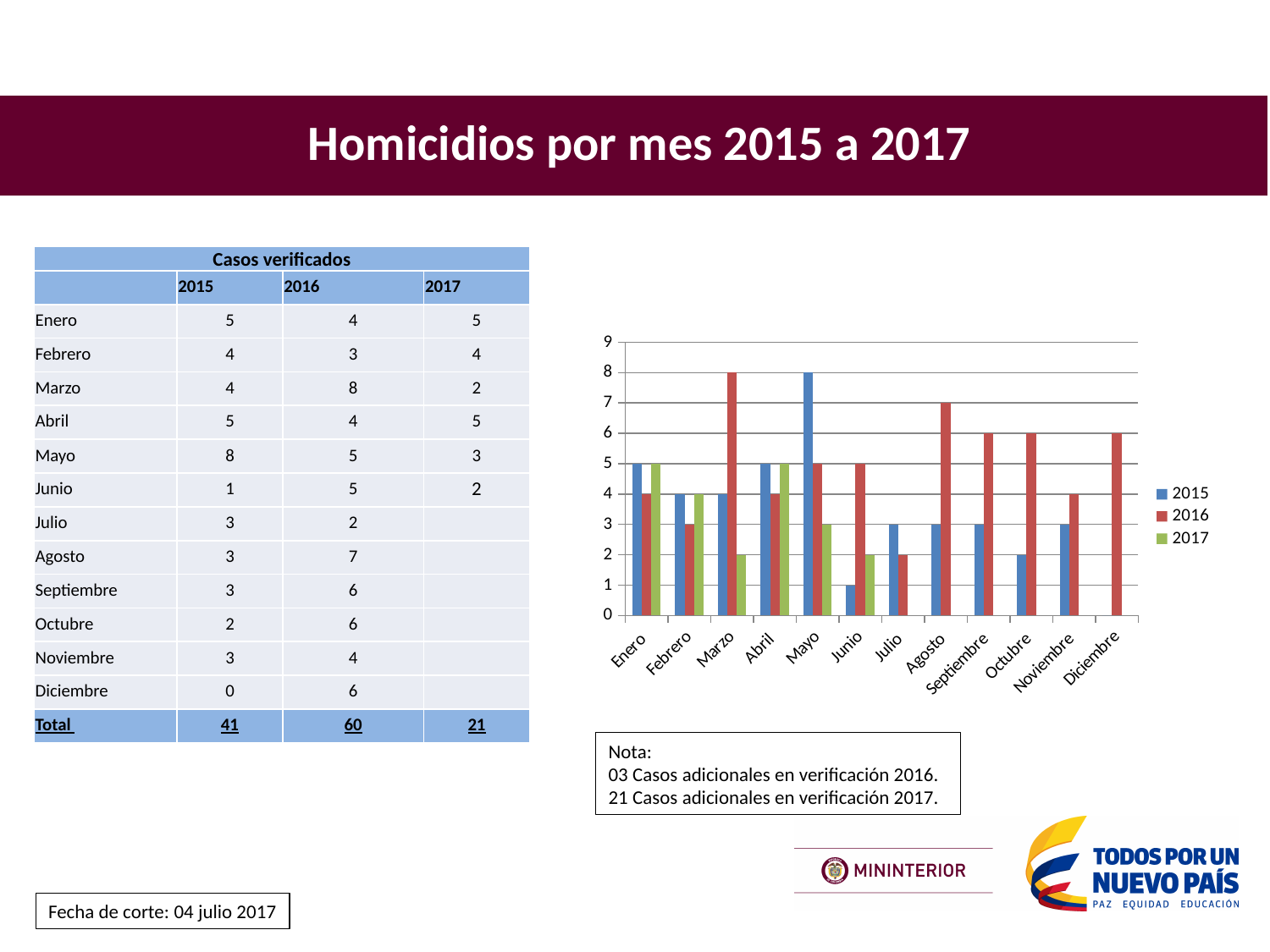
Is the value for 2016 in Septiembre greater or less than 5? greater How many series does the chart legend list? 3 What is the difference between the 2016 and 2015 values in Agosto? 4 Which month has the lowest value for the 2015 series? Diciembre What is the value for 2015 in Mayo? 8 Which series is shown in green in the chart legend? 2017 What is the value for 2016 in Marzo? 8 Which month has the highest value for the 2015 series? Mayo How many months are shown along the x axis of the chart? 12 What is the value for 2017 in Junio? 2 What kind of chart is shown on the slide? bar chart In Junio, which series has the larger value, 2015 or 2016? 2016